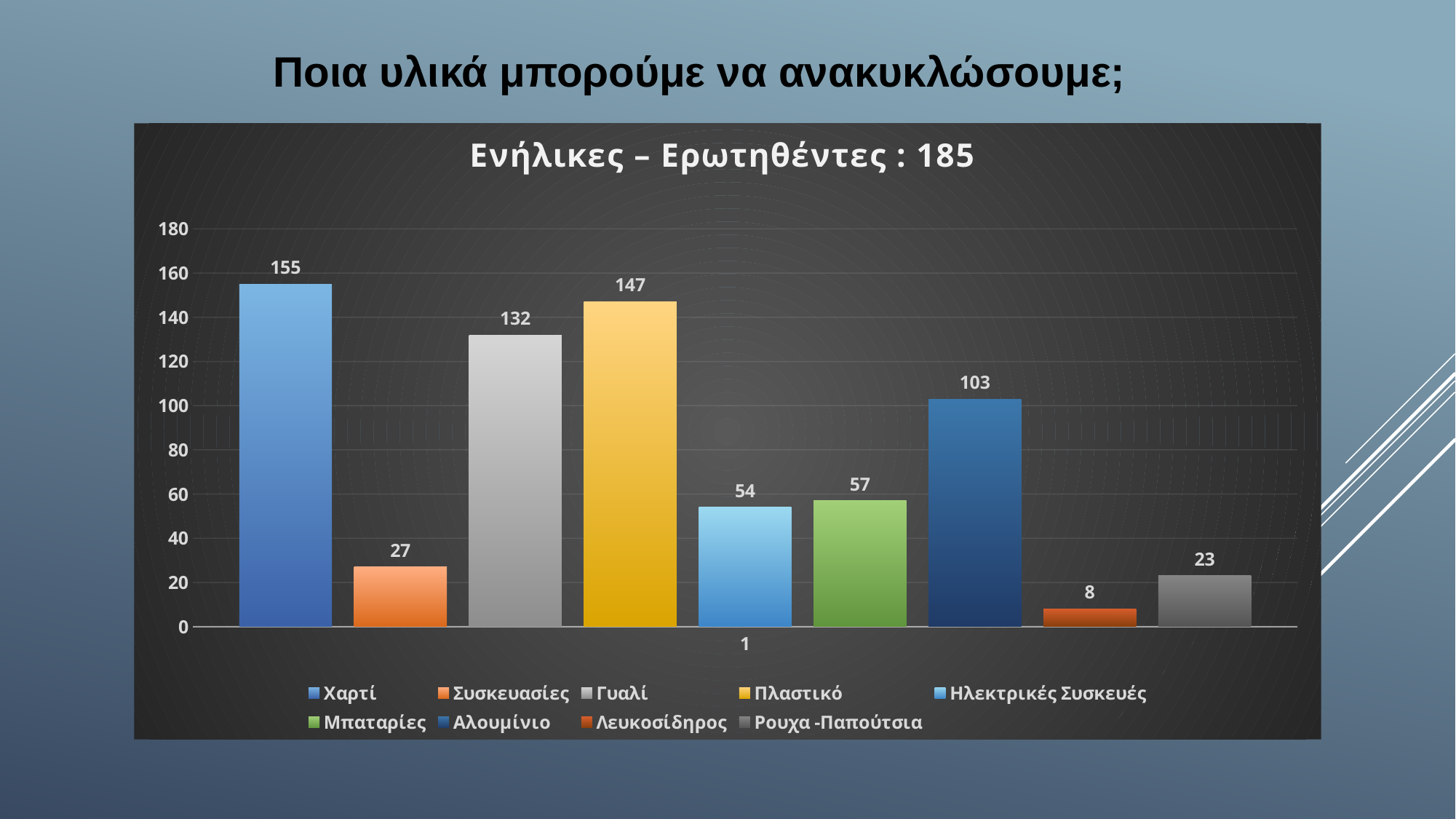
Which series has the highest value? Χαρτί What is the value for Πλαστικό? 147 Which series has the lowest value? Λευκοσίδηρος What is the value for Χαρτί? 155 What is the value for Λευκοσίδηρος? 8 Which is larger, the value for Μπαταρίες or the value for Ηλεκτρικές Συσκευές? Μπαταρίες What is the value for Αλουμίνιο? 103 What is the title of the chart? Ενήλικες – Ερωτηθέντες : 185 What kind of chart is shown on the slide? Bar chart How many series does the legend list? 9 What is the difference between the values for Χαρτί and Γυαλί? 23 What is the difference between the values for Συσκευασίες and Ρουχα -Παπούτσια? 4